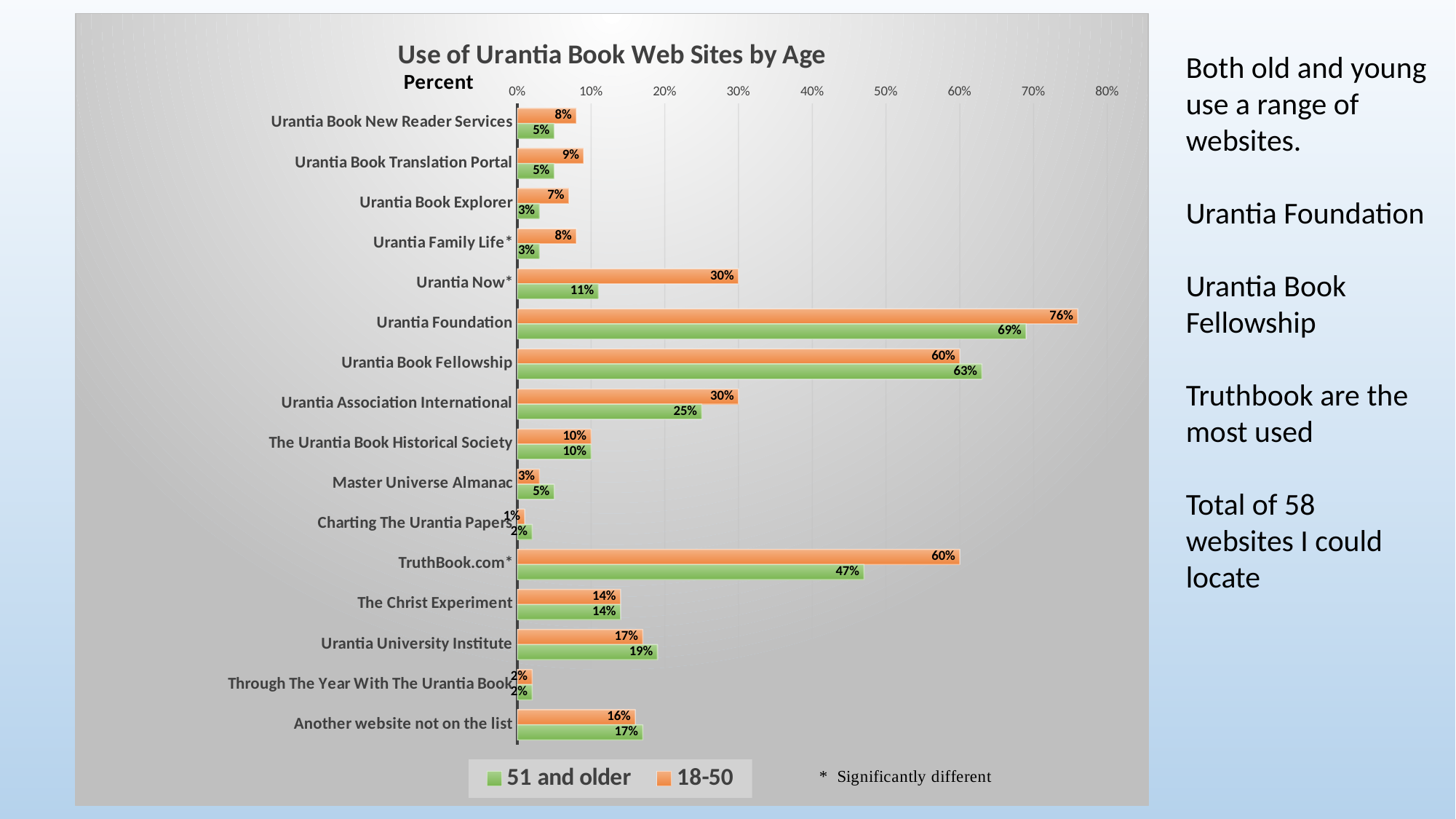
For Urantia Book Fellowship, which series has the larger value, 18-50 or 51 and older? 51 and older What is the value for Urantia Foundation in the 18-50 series? 76% Which website has the lowest value in the 18-50 series? Charting The Urantia Papers What is the difference between the 18-50 and 51 and older values for TruthBook.com? 13% What is the value for TruthBook.com in the 51 and older series? 47% How many series does the legend list? 2 How many websites (categories) are plotted on the chart? 16 Which colour represents the 18-50 series in the legend? Orange What is the value for Urantia Now in the 51 and older series? 11% What is the difference between the 18-50 and 51 and older values for Urantia Now? 19% What kind of chart is shown on the slide? Bar chart Which website has the highest value in the 18-50 series? Urantia Foundation